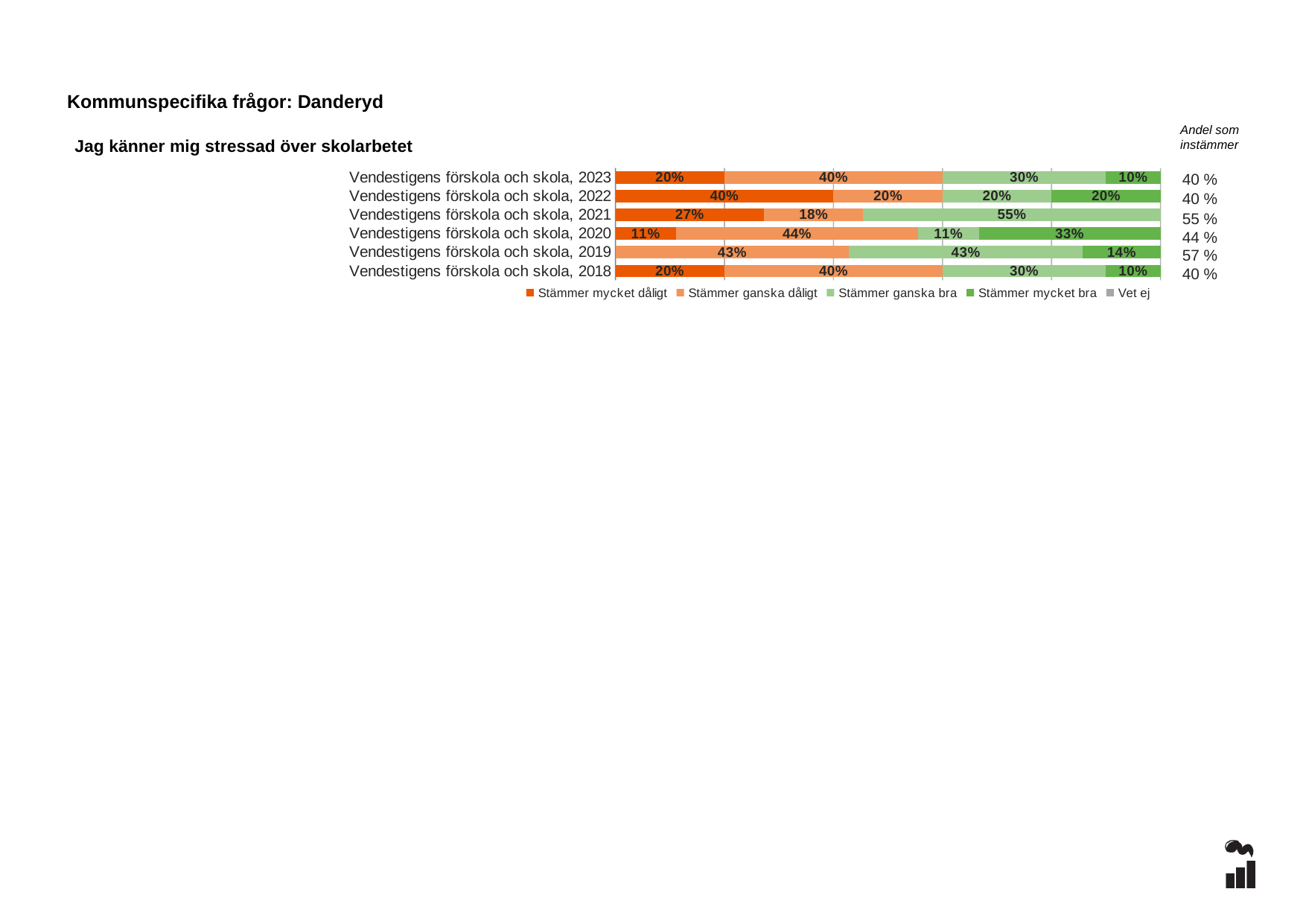
Which year has the highest value for "Stämmer mycket bra"? Vendestigens förskola och skola, 2020 What is the difference between the "Stämmer mycket dåligt" values for 2022 and 2023? 20 percentage points What kind of chart is shown on the slide? Stacked bar chart How many series does the legend list? 5 What is the value for "Stämmer ganska dåligt" for Vendestigens förskola och skola, 2023? 40% How many bars (categories) are shown in the chart? 6 What is the value for "Stämmer mycket bra" for Vendestigens förskola och skola, 2020? 33% Which has the larger "Stämmer ganska dåligt" value, 2020 or 2021? Vendestigens förskola och skola, 2020 What is the "Andel som instämmer" value shown for Vendestigens förskola och skola, 2019? 57 % Which year has the highest value for "Stämmer ganska bra"? Vendestigens förskola och skola, 2021 What is the value for "Stämmer ganska bra" for Vendestigens förskola och skola, 2021? 55%